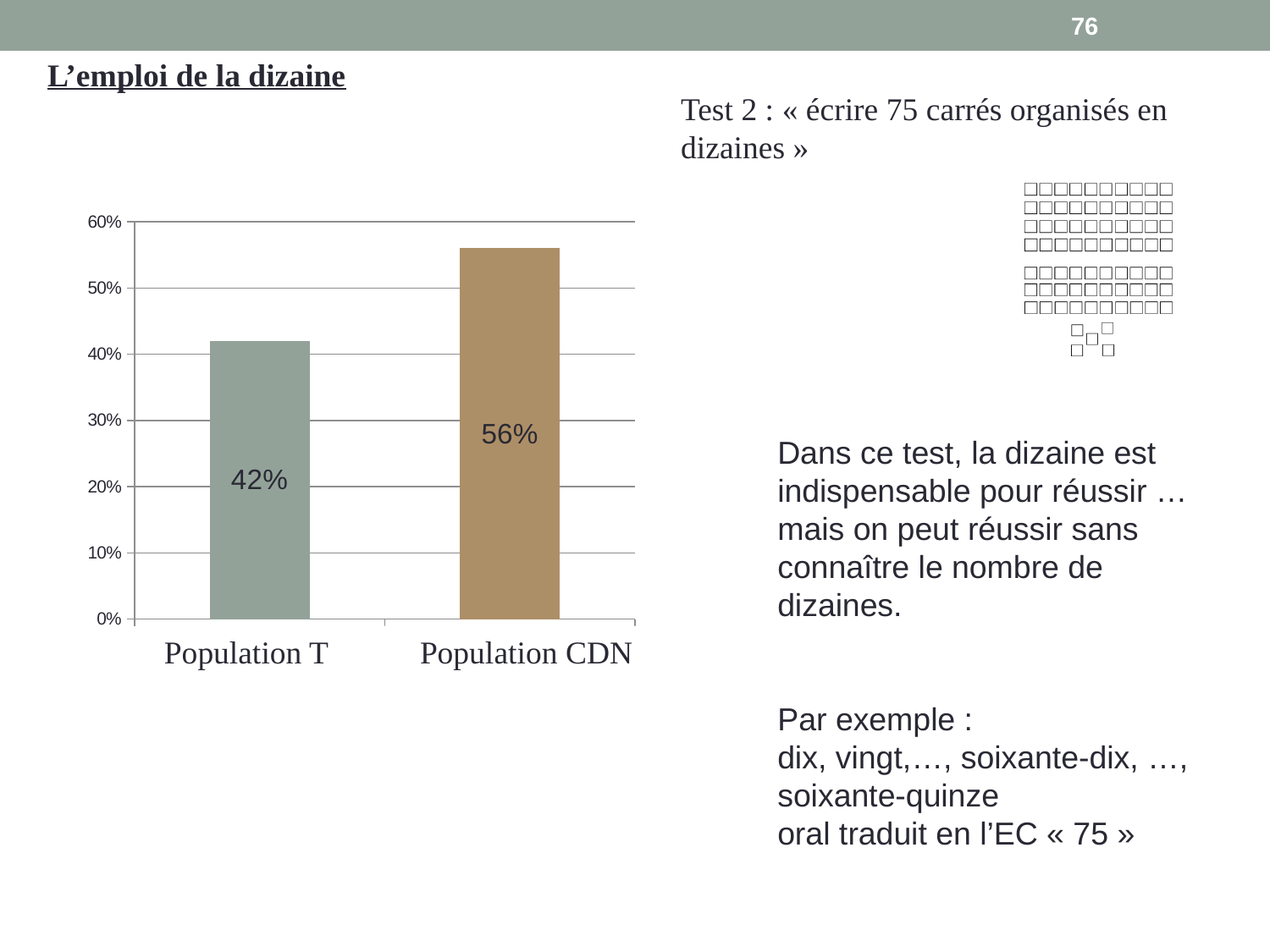
Is the value for Population CDN greater or less than 50%? greater Which is larger, the value for Population T or the value for Population CDN? Population CDN What is the difference between the values for Population CDN and Population T? 14% What colour is the bar for Population CDN? brown What is the maximum value shown on the vertical axis of the chart? 60% How many categories are shown in the chart? 2 What is the value for Population T? 42% What kind of chart is shown on the slide? bar chart Which category has the highest value? Population CDN Is the value for Population T greater or less than 50%? less What is the value for Population CDN? 56% Which category has the lowest value? Population T